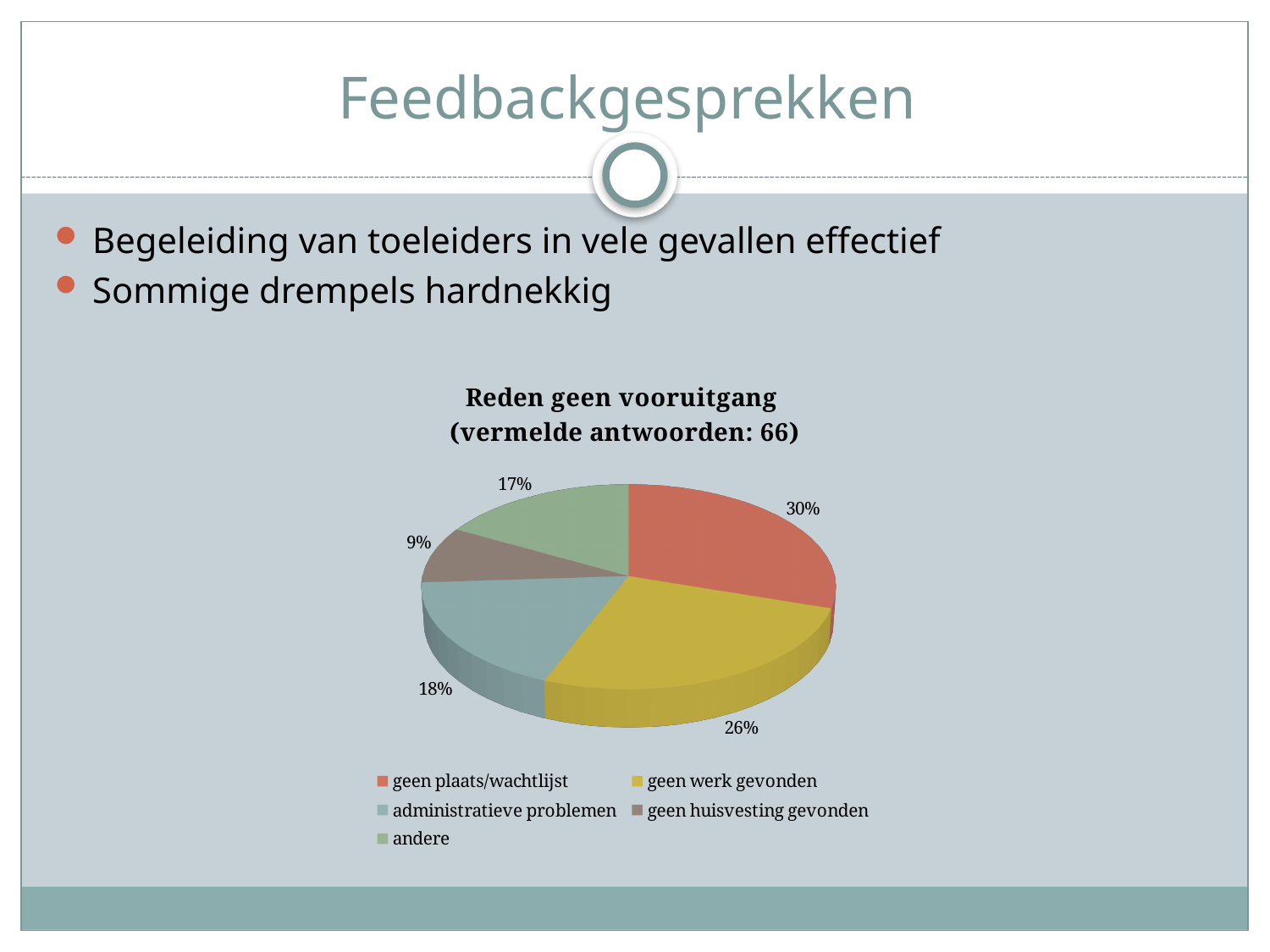
Which is larger: the slice for 'administratieve problemen' or the slice for 'andere'? administratieve problemen What percentage is shown for 'andere'? 17% What is the difference in percentage points between 'geen plaats/wachtlijst' and 'geen werk gevonden'? 4 What percentage is shown for 'geen werk gevonden'? 26% What share of the pie does 'geen plaats/wachtlijst' represent? 30% Which category has the smallest slice of the pie? geen huisvesting gevonden What kind of chart is shown on the slide? pie chart Which category has the largest slice of the pie? geen plaats/wachtlijst What is the title of the chart? Reden geen vooruitgang (vermelde antwoorden: 66) What percentage is shown for 'administratieve problemen'? 18% What percentage is shown for 'geen huisvesting gevonden'? 9% How many categories does the pie chart show? 5